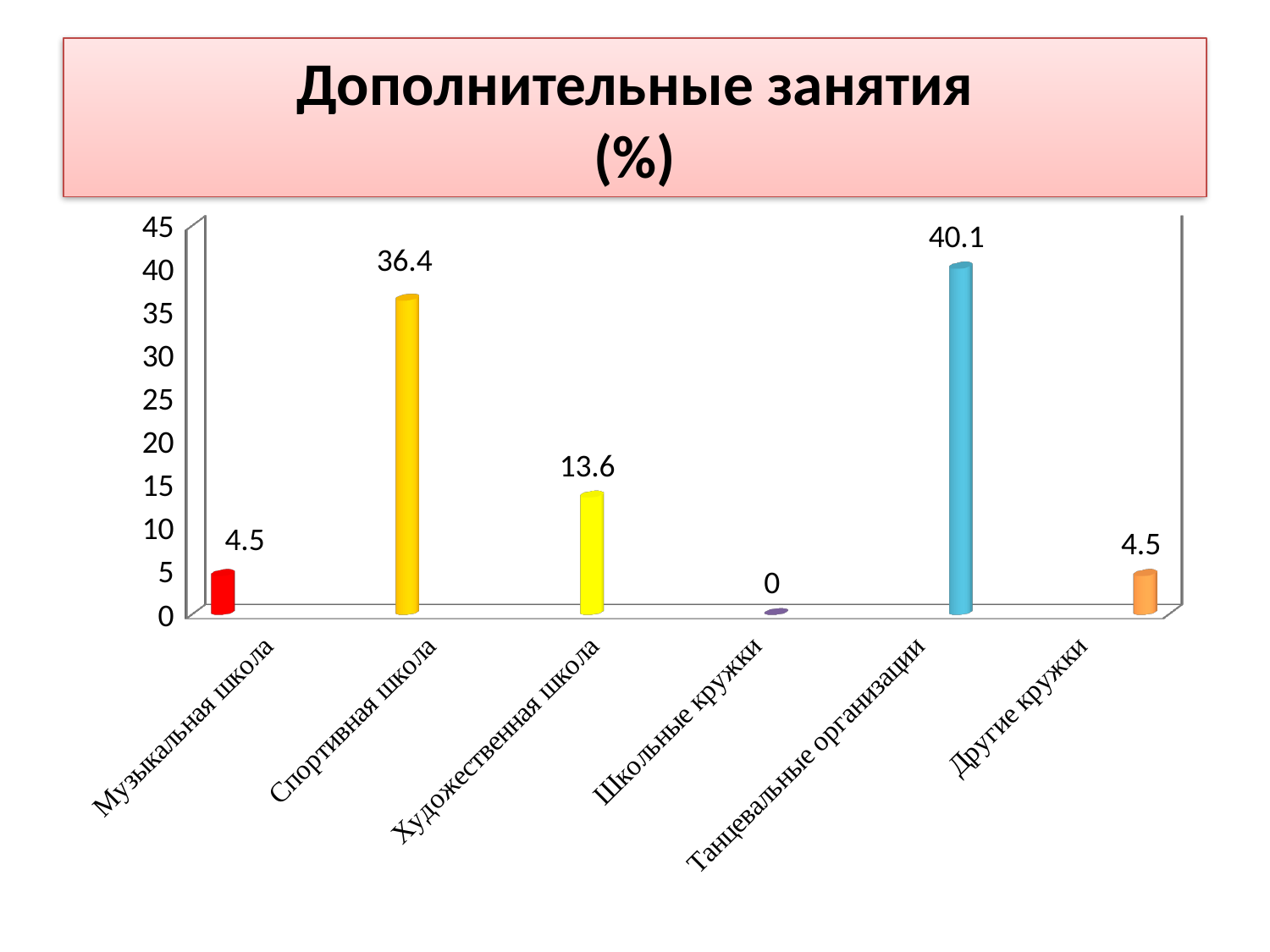
How many categories are shown on the chart? 6 Which category has the lowest value? Школьные кружки What is the difference between the values for Спортивная школа and Художественная школа? 22.8 What is the value for Художественная школа? 13.6 What kind of chart is shown on the slide? bar chart What is the value for Спортивная школа? 36.4 What is the value for Танцевальные организации? 40.1 What is the value for Школьные кружки? 0 Which category has the highest value? Танцевальные организации What is the title of the chart? Дополнительные занятия (%) What is the difference between the values for Танцевальные организации and Спортивная школа? 3.7 Which is larger, the value for Художественная школа or the value for Музыкальная школа? Художественная школа